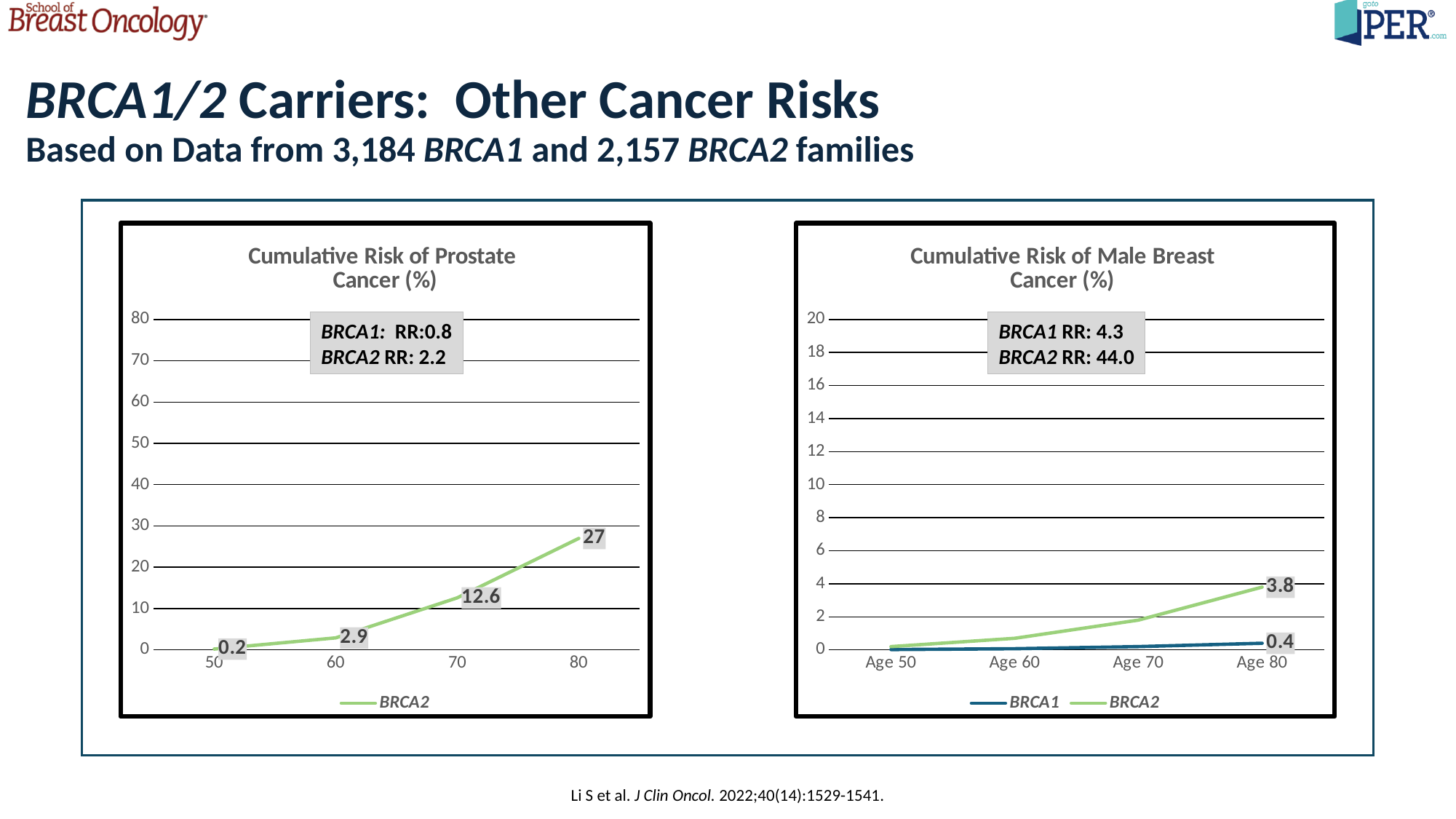
In the Cumulative Risk of Prostate Cancer chart, what is the BRCA2 value at age 50? 0.2 How many series does the legend of the Cumulative Risk of Male Breast Cancer chart list? 2 In the Cumulative Risk of Prostate Cancer chart, what is the difference between the BRCA2 values at age 80 and age 70? 14.4 In the Cumulative Risk of Prostate Cancer chart, what is the BRCA2 value at age 80? 27 In the Cumulative Risk of Prostate Cancer chart, is the BRCA2 value at age 80 greater or less than 30? less In the Cumulative Risk of Male Breast Cancer chart, what is the BRCA2 value at Age 80? 3.8 In the Cumulative Risk of Prostate Cancer chart, at which age is the BRCA2 value highest? 80 In the Cumulative Risk of Male Breast Cancer chart, what is the BRCA1 value at Age 80? 0.4 In the Cumulative Risk of Male Breast Cancer chart, which series has the larger value at Age 80, BRCA1 or BRCA2? BRCA2 What kind of chart is the Cumulative Risk of Prostate Cancer chart? line chart In the Cumulative Risk of Prostate Cancer chart, does the BRCA2 line rise or fall as age increases? rises In the Cumulative Risk of Prostate Cancer chart, what is the BRCA2 value at age 70? 12.6